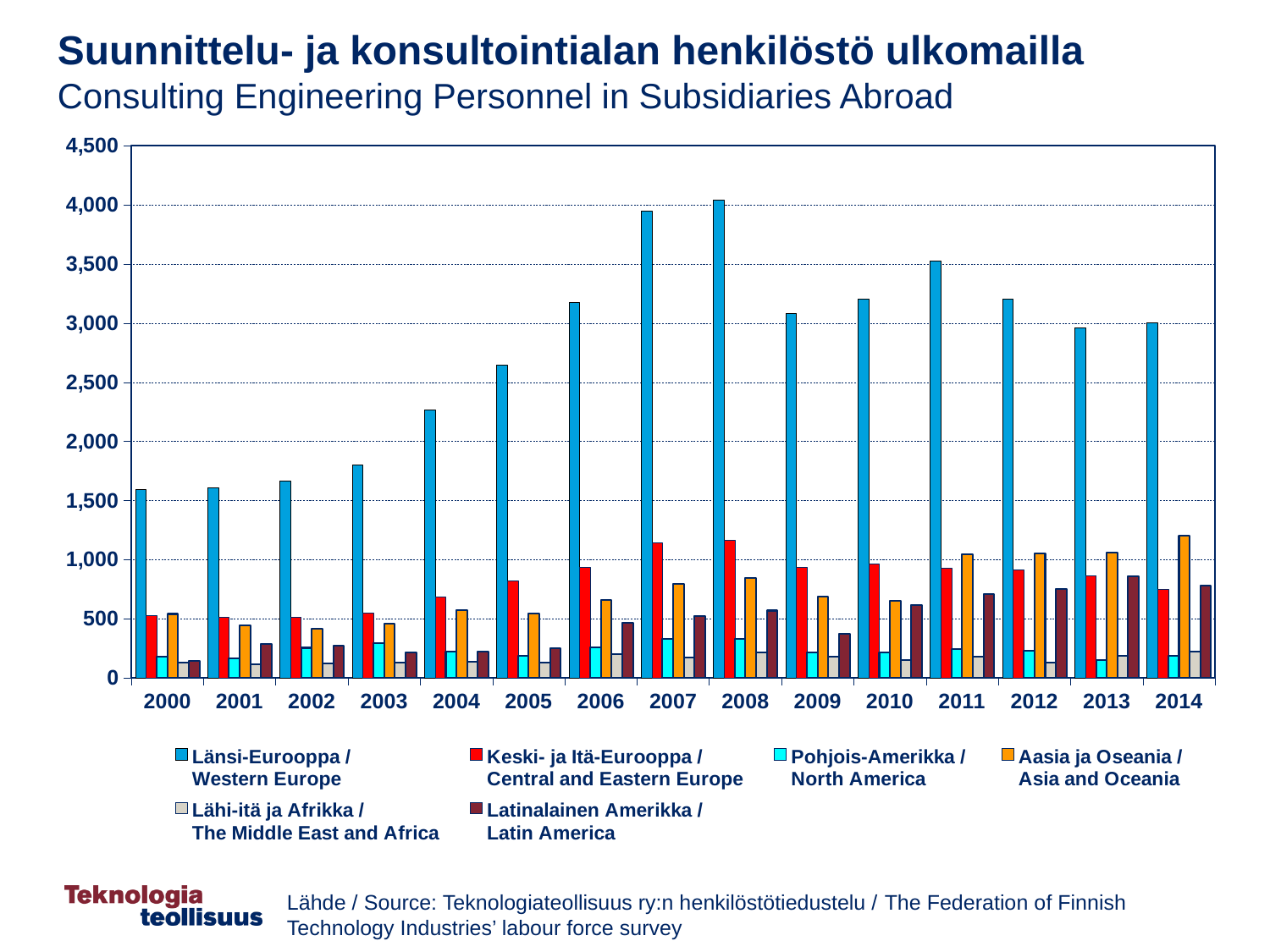
In which year is the Asia and Oceania value highest? 2014 Is the Asia and Oceania value for 2014 greater or less than 1,000? greater How many years are shown on the x axis? 15 How many series does the legend list? 6 Which is larger in 2014: the Asia and Oceania value or the Central and Eastern Europe value? Asia and Oceania What kind of chart is shown on the slide? bar chart Is the Central and Eastern Europe value for 2007 greater or less than 1,000? greater Is the Latin America value for 2000 greater or less than 500? less Does the Western Europe value rise or fall from 2000 to 2008? rise What is the English title of the chart? Consulting Engineering Personnel in Subsidiaries Abroad In which year is the Western Europe value highest? 2008